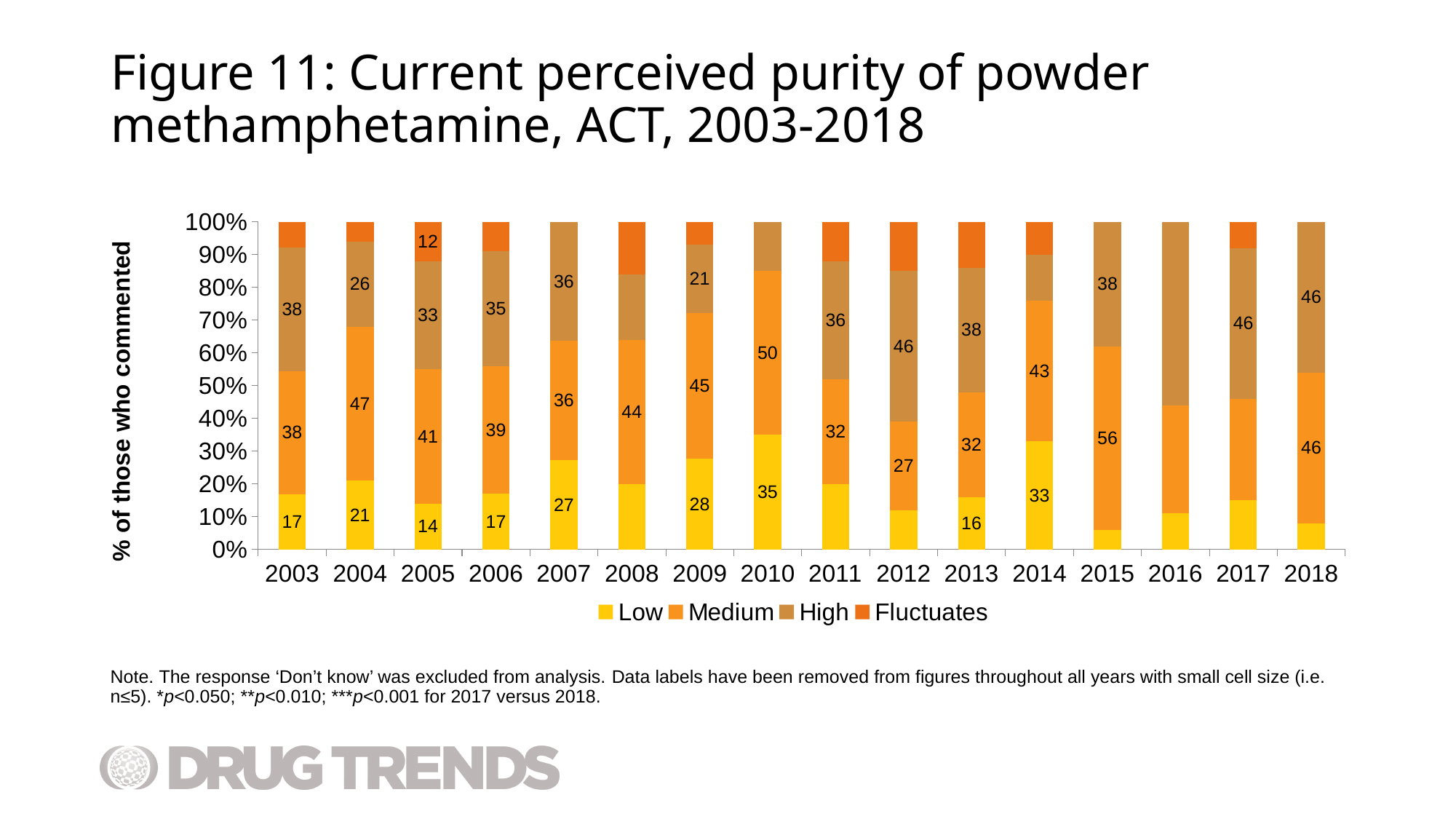
What is the difference between the Medium and Low values in 2004? 26 Is the Low segment for 2016 greater or less than 20%? less Among the years with a printed Low label, which year has the highest Low value? 2010 What is the value for Fluctuates in 2005? 12 How many series does the legend list? 4 What is the value for Low in 2010? 35 What kind of chart is shown on the slide? Stacked bar chart How many years are shown on the x axis? 16 What is the value for High in 2012? 46 Which year has the larger Medium value, 2009 or 2011? 2009 What is the value for Medium in 2018? 46 What is the value for Medium in 2015? 56